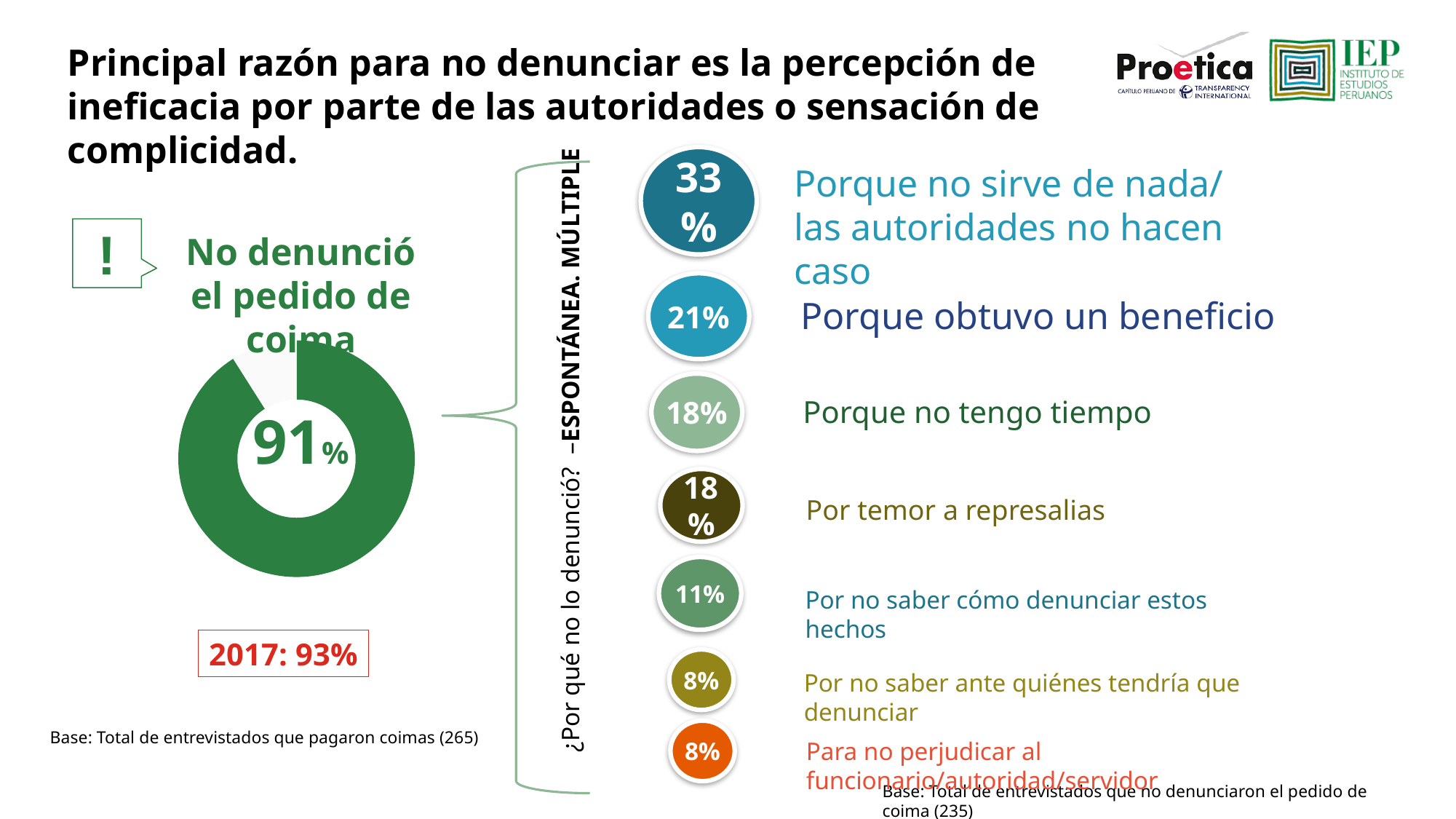
What percentage of respondents gave 'Por temor a represalias' as a reason for not reporting? 18% What is the lowest percentage shown among the reasons for not reporting? 8% According to the red box below the donut chart, what was the percentage who did not report in 2017? 93% What percentage of respondents gave 'Porque obtuvo un beneficio' as a reason for not reporting? 21% What is the base (number of respondents) for the donut chart showing 91%? 265 (Total de entrevistados que pagaron coimas) What is the difference in percentage points between 'Porque no sirve de nada/las autoridades no hacen caso' (33%) and 'Porque obtuvo un beneficio' (21%)? 12 percentage points By how many percentage points did the share who did not report the bribe request change from 2017 (93%) to the current value (91%)? 2 percentage points lower In the donut chart, what percentage of respondents did not report the bribe request (No denunció el pedido de coima)? 91% In the list of reasons for not reporting, which reason has the highest percentage? Porque no sirve de nada/las autoridades no hacen caso (33%) How many reasons for not reporting are listed on the right side of the slide? 7 What kind of chart is used to show the share of respondents who did not report the bribe request? Pie (donut) chart Which reason has a higher percentage: 'Por no saber cómo denunciar estos hechos' or 'Por no saber ante quiénes tendría que denunciar'? Por no saber cómo denunciar estos hechos (11%)